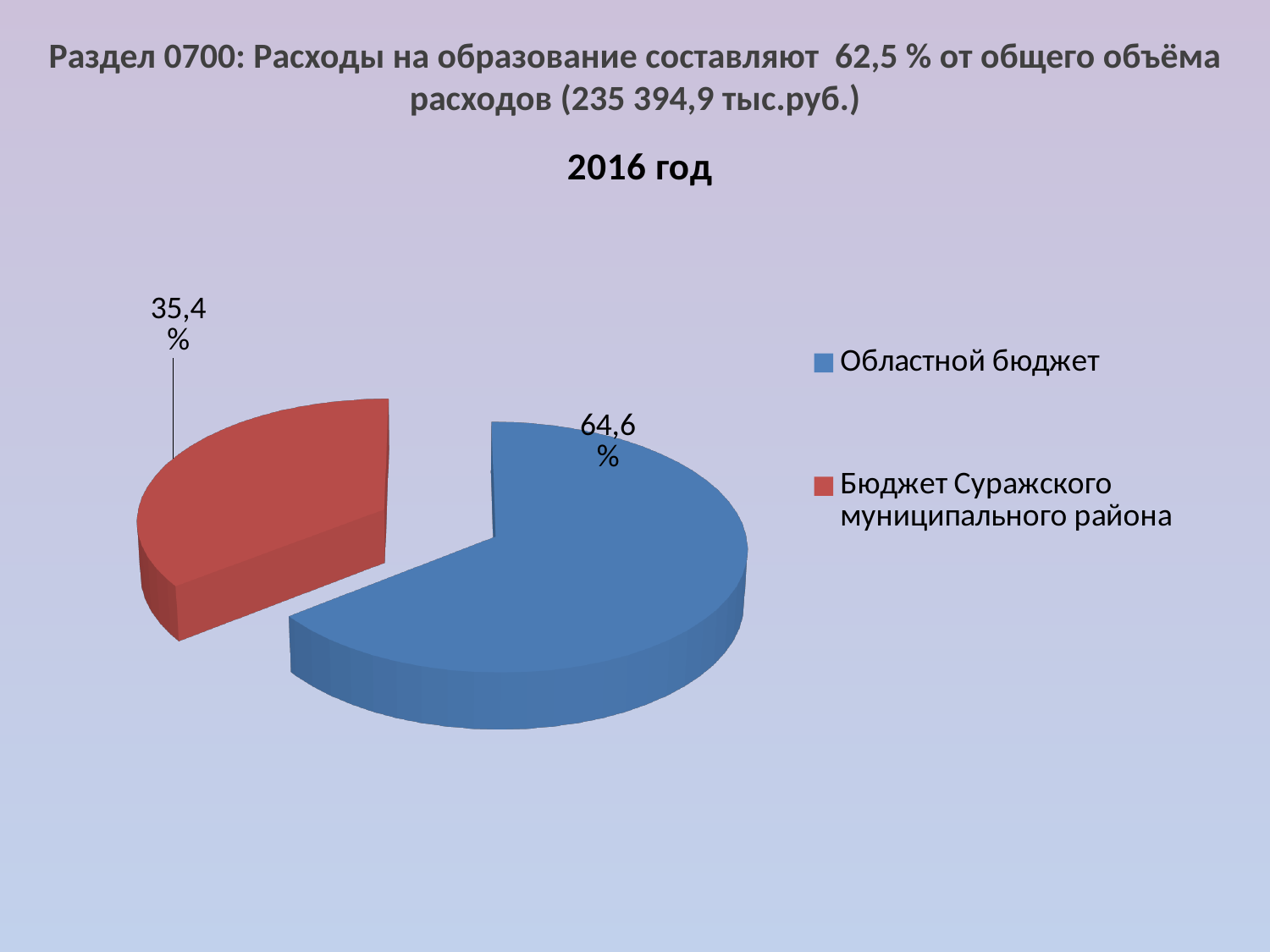
What kind of chart is shown on the slide? Pie chart What share of the pie does Бюджет Суражского муниципального района have? 35,4% How many slices does the pie chart have? 2 What colour is the slice for Областной бюджет? Blue Which is larger: Областной бюджет or Бюджет Суражского муниципального района? Областной бюджет What is the title of the chart? 2016 год Which slice is the smallest? Бюджет Суражского муниципального района How many entries does the legend list? 2 What is the difference in percentage points between Областной бюджет and Бюджет Суражского муниципального района? 29,2 Which slice is the largest? Областной бюджет What share of the pie does Областной бюджет have? 64,6%